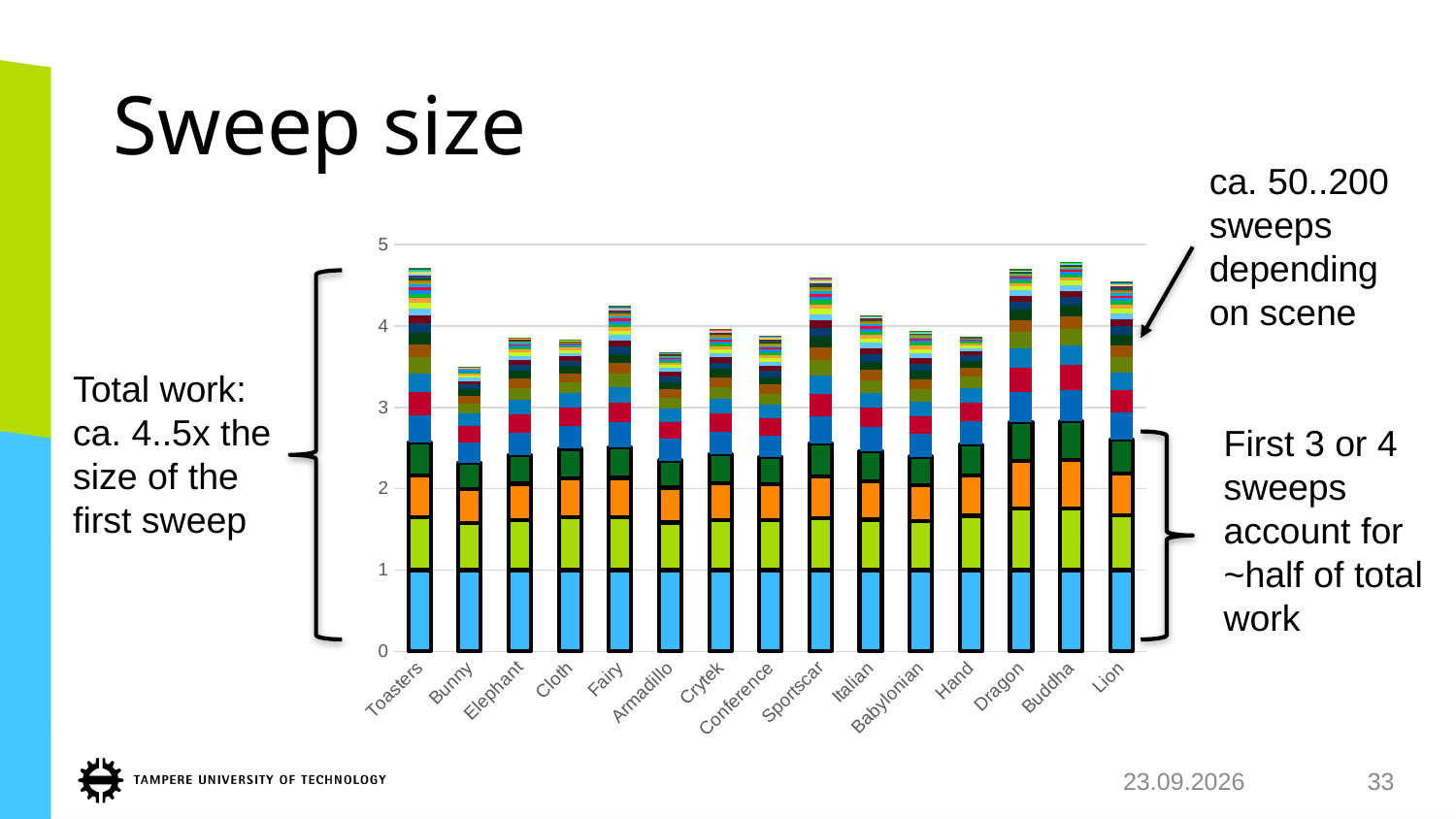
Is the total bar height for Armadillo greater or less than 4? less Is the total bar height for Buddha greater or less than 4? greater Is the total bar height for Hand greater or less than 4? less How many scenes (categories) are plotted along the x axis? 15 Which bar is taller, Buddha or Bunny? Buddha Which bar is taller, Fairy or Elephant? Fairy What kind of chart is shown on the slide? stacked bar chart What is the title of the slide containing the chart? Sweep size What is the height of the bottom (light blue) segment of the Toasters bar? 1